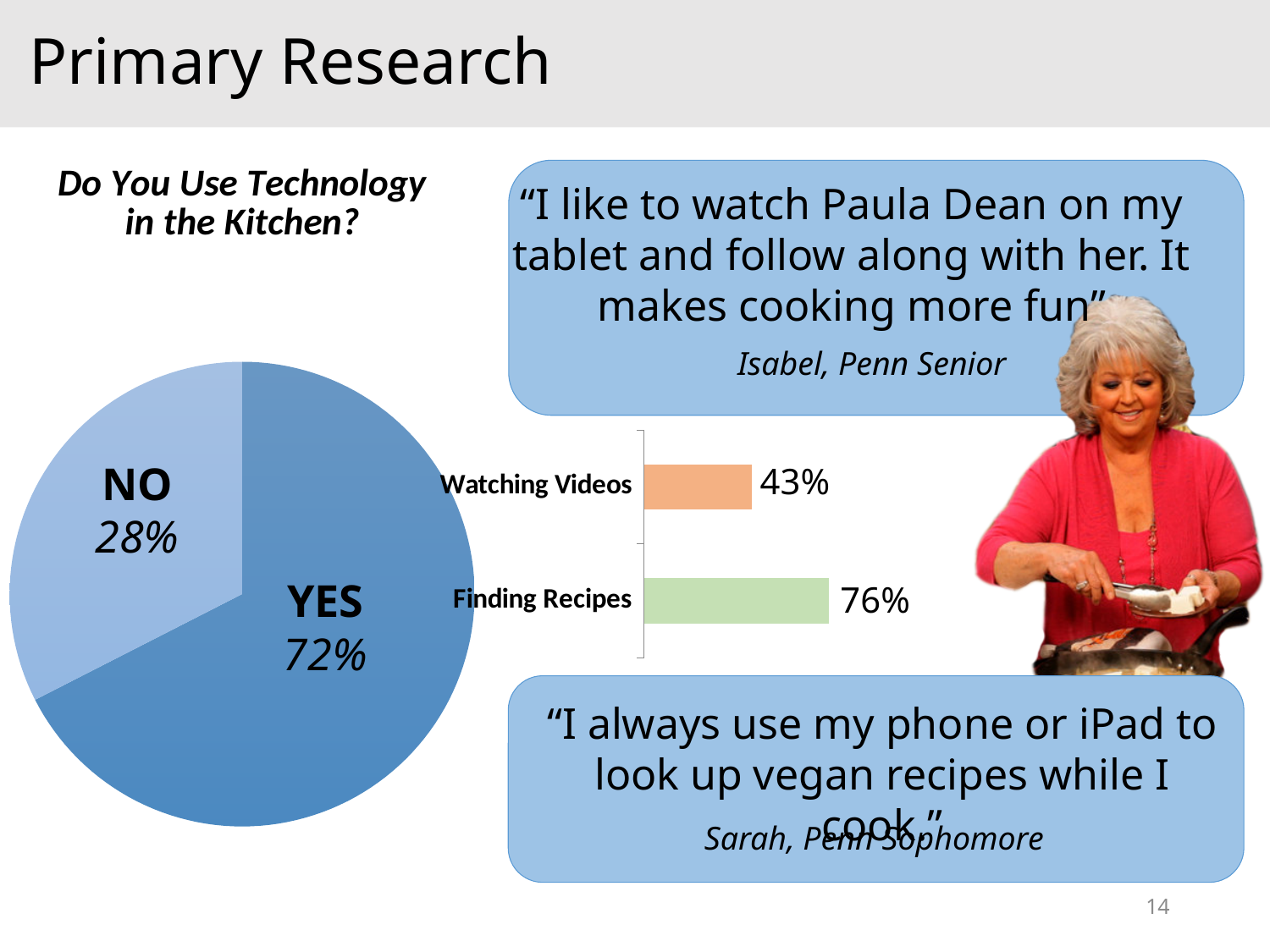
In the bar chart in the middle of the slide, which category has the lowest value? Watching Videos In the pie chart titled "Do You Use Technology in the Kitchen?", which slice is larger, YES or NO? YES In the pie chart titled "Do You Use Technology in the Kitchen?", how many slices are there? 2 In the pie chart titled "Do You Use Technology in the Kitchen?", what share of respondents answered YES? 72% In the bar chart in the middle of the slide, what is the value for Finding Recipes? 76% In the pie chart titled "Do You Use Technology in the Kitchen?", what is the difference in percentage points between the YES and NO slices? 44 percentage points What kind of chart is the chart on the left of the slide? Pie chart In the bar chart in the middle of the slide, which category has the highest value? Finding Recipes In the bar chart in the middle of the slide, what is the value for Watching Videos? 43% In the bar chart in the middle of the slide, what is the difference between Finding Recipes and Watching Videos? 33 percentage points In the pie chart titled "Do You Use Technology in the Kitchen?", what share of respondents answered NO? 28% What kind of chart is the chart in the middle of the slide? Bar chart